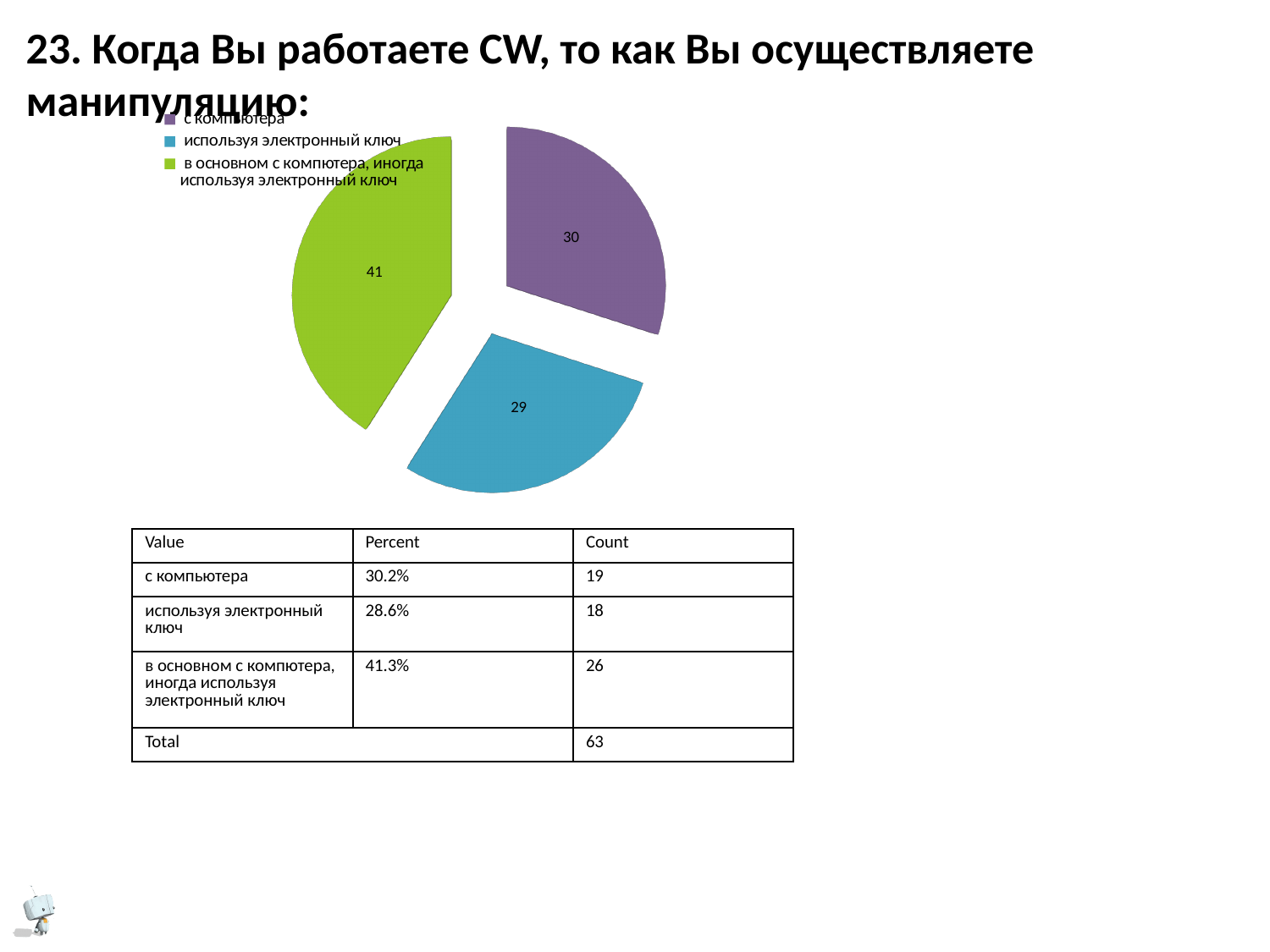
How many entries does the legend of the pie chart list? 3 What is the difference between the values printed on the purple slice and the blue slice of the pie chart? 1 Which category has the smallest slice in the pie chart? используя электронный ключ Which colour represents 'используя электронный ключ' in the pie chart? blue What is the difference between the values printed on the green slice and the blue slice of the pie chart? 12 How many slices does the pie chart have? 3 Which colour represents 'с компьютера' in the pie chart? purple What value is printed on the blue slice (используя электронный ключ) of the pie chart? 29 Which category has the largest slice in the pie chart? в основном с компютера, иногда используя электронный ключ What value is printed on the purple slice (с компьютера) of the pie chart? 30 What type of chart is shown on the slide? pie chart What value is printed on the green slice (в основном с компютера, иногда используя электронный ключ) of the pie chart? 41